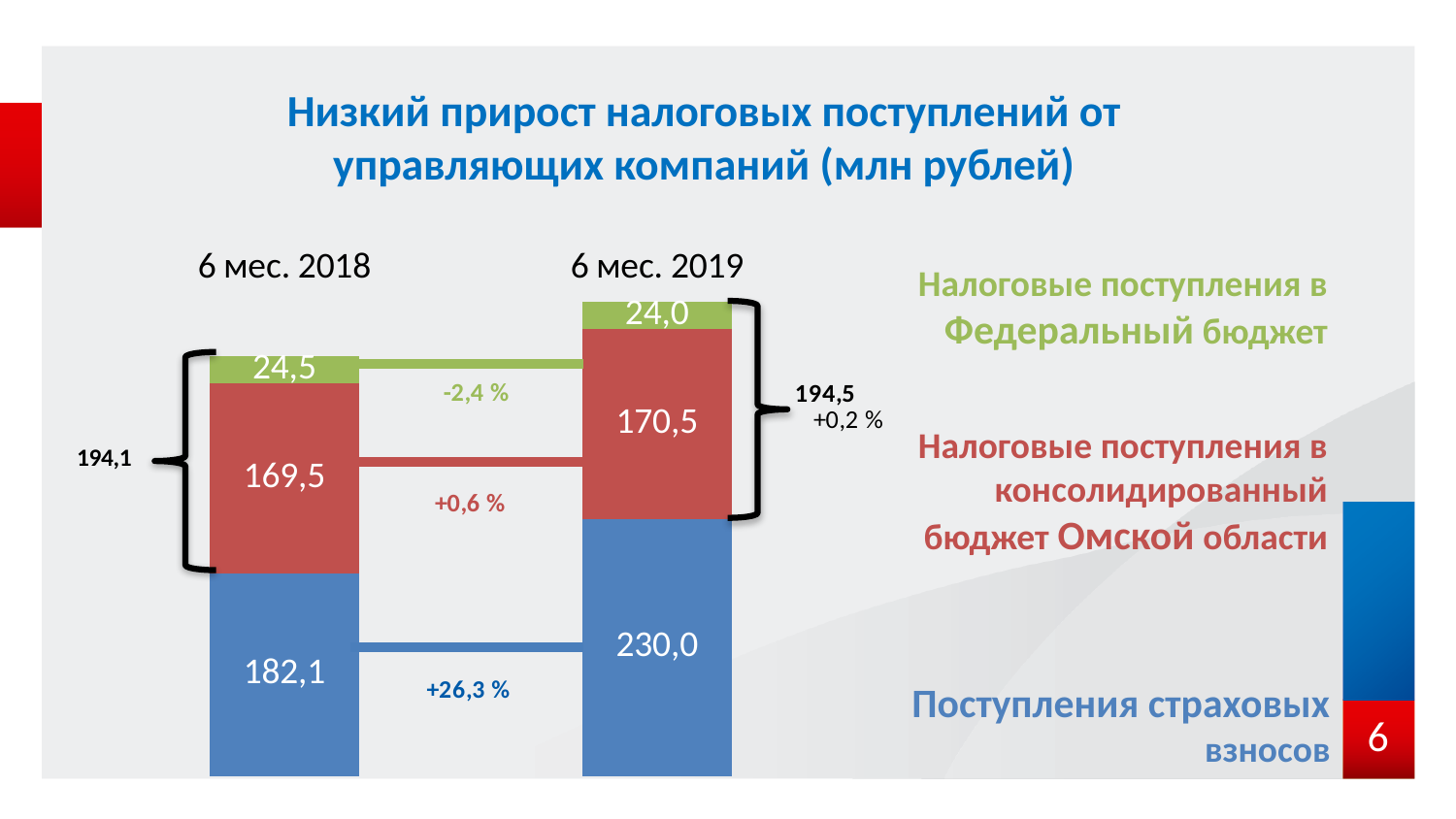
Which segment is the smallest in the 6 мес. 2018 bar? Налоговые поступления в Федеральный бюджет (24,5) What type of chart is shown on the slide? stacked bar chart How many series (segments) does each bar contain? 3 What percentage change is shown for the green segment (Федеральный бюджет) between the two periods? -2,4 % What is the value of the blue segment (Поступления страховых взносов) for 6 мес. 2019? 230,0 How many bars (periods) are shown in the chart? 2 What is the value of the red segment (консолидированный бюджет Омской области) for 6 мес. 2018? 169,5 What is the value of the green segment (Федеральный бюджет) for 6 мес. 2019? 24,0 What is the difference between the blue segment values for 6 мес. 2019 and 6 мес. 2018? 47,9 What percentage change is shown for the blue segment (страховые взносы) between 6 мес. 2018 and 6 мес. 2019? +26,3 % What is the bracketed total of tax revenues (green plus red segments) for 6 мес. 2018? 194,1 Which segment is the largest in the 6 мес. 2019 bar? Поступления страховых взносов (230,0)